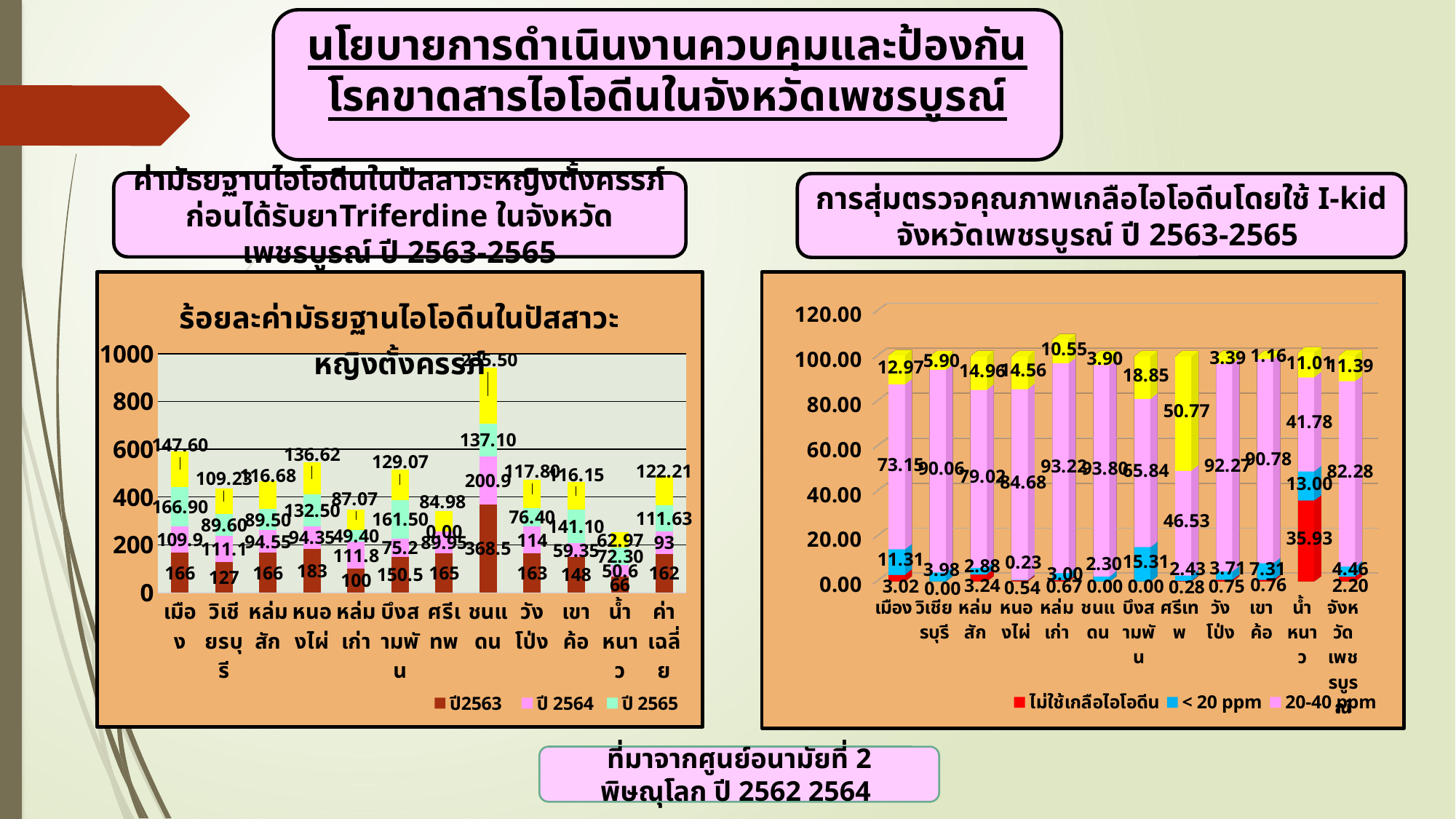
In the right chart, which category has the highest ไม่ใช้เกลือไอโอดีน value? น้ำหนาว In the right chart, which is larger: the ไม่ใช้เกลือไอโอดีน value for เมือง or for หล่มสัก? หล่มสัก In the left chart, what is the ปี2563 value for หนองไผ่? 183 In the right chart (การสุ่มตรวจคุณภาพเกลือไอโอดีน), what is the ไม่ใช้เกลือไอโอดีน value for น้ำหนาว? 35.93 In the left chart, which category has the highest ปี2563 value? ชนแดน In the left chart, which category has the lowest ปี2563 value? น้ำหนาว In the left chart, what is the difference between the ปี2563 values for หนองไผ่ and หล่มเก่า? 83 In the right chart, what is the < 20 ppm value for ศรีเทพ? 2.43 In the left chart, what is the ปี2563 value for ชนแดน? 368.5 What kind of chart is the left chart (ร้อยละค่ามัธยฐานไอโอดีนในปัสสาวะหญิงตั้งครรภ์)? bar chart How many categories are shown on the x axis of the left chart? 12 In the right chart, what is the 20-40 ppm value for จังหวัดเพชรบูรณ์? 82.28